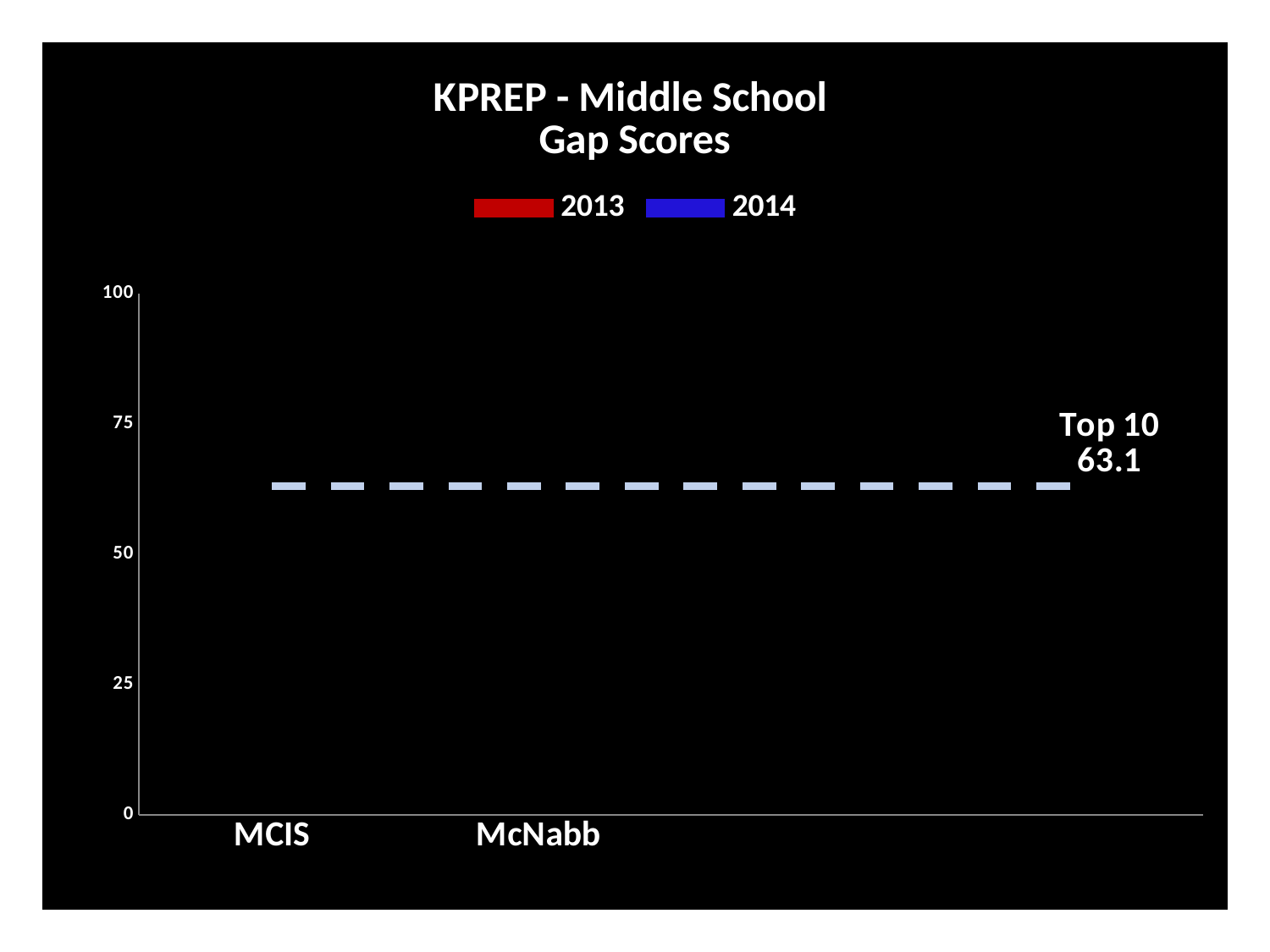
What is the title of the chart? KPREP - Middle School Gap Scores Is the 'Top 10' reference line value greater or less than 75? less What is the maximum value shown on the y axis? 100 Is the 'Top 10' reference line value greater or less than 50? greater What value is the dashed 'Top 10' reference line labeled with? 63.1 How many series does the legend list? 2 How many categories are labeled on the x axis? 2 Which years are listed in the chart's legend? 2013 and 2014